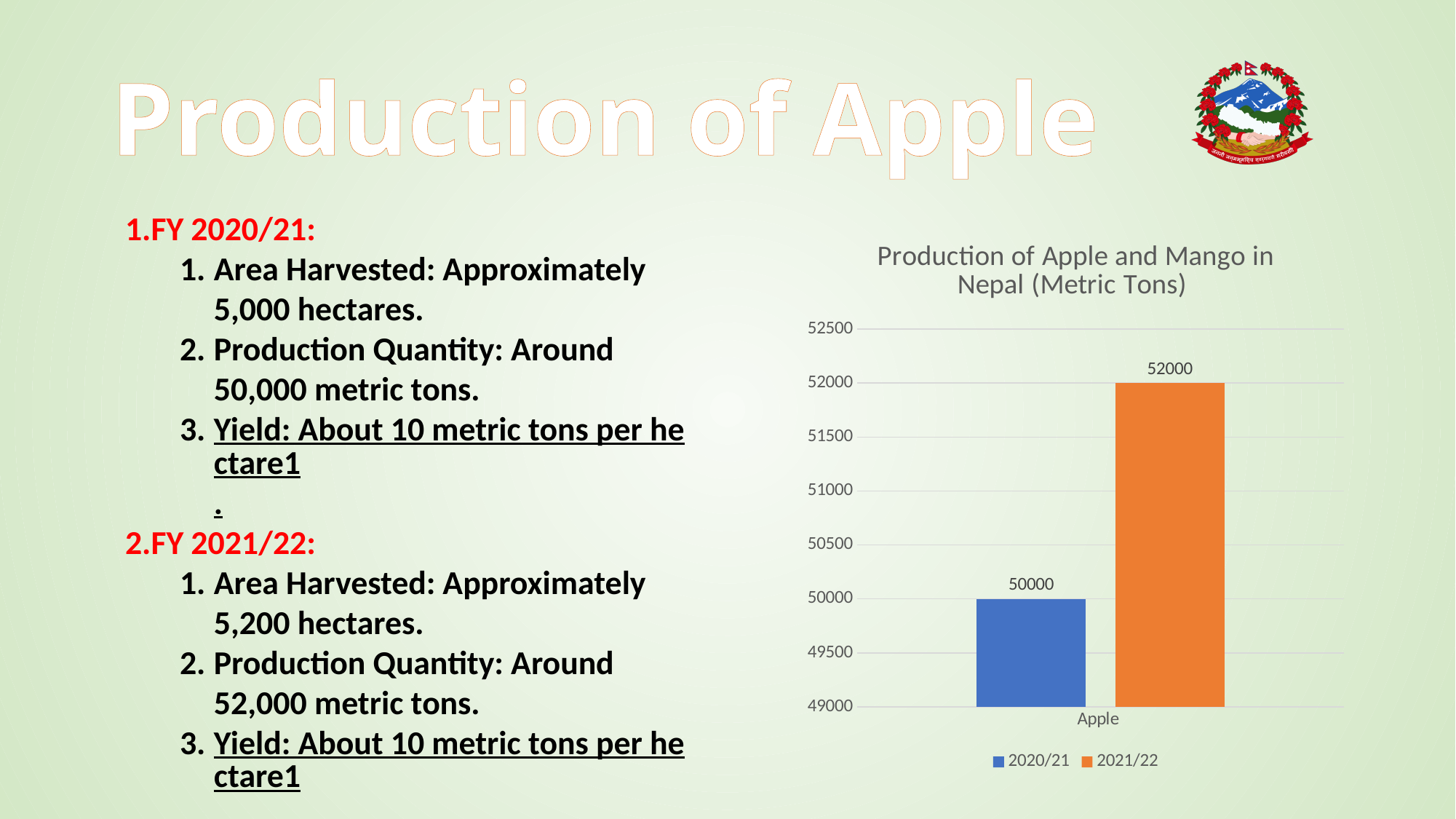
What kind of chart is shown on the slide? Bar chart What is the difference between the 2021/22 and 2020/21 values in the chart? 2000 What is the production value for 2021/22 in the chart? 52000 Is the value for 2020/21 greater or less than 50500? less What is the title of the chart? Production of Apple and Mango in Nepal (Metric Tons) Which series has the higher value in the chart, 2020/21 or 2021/22? 2021/22 Is the value for 2021/22 greater or less than 51000? greater How many series does the chart legend list? 2 What is the production value for 2020/21 in the chart? 50000 How many categories are shown on the x axis of the chart? 1 Which series has the lowest value in the chart? 2020/21 What colour is the bar for the 2021/22 series? Orange